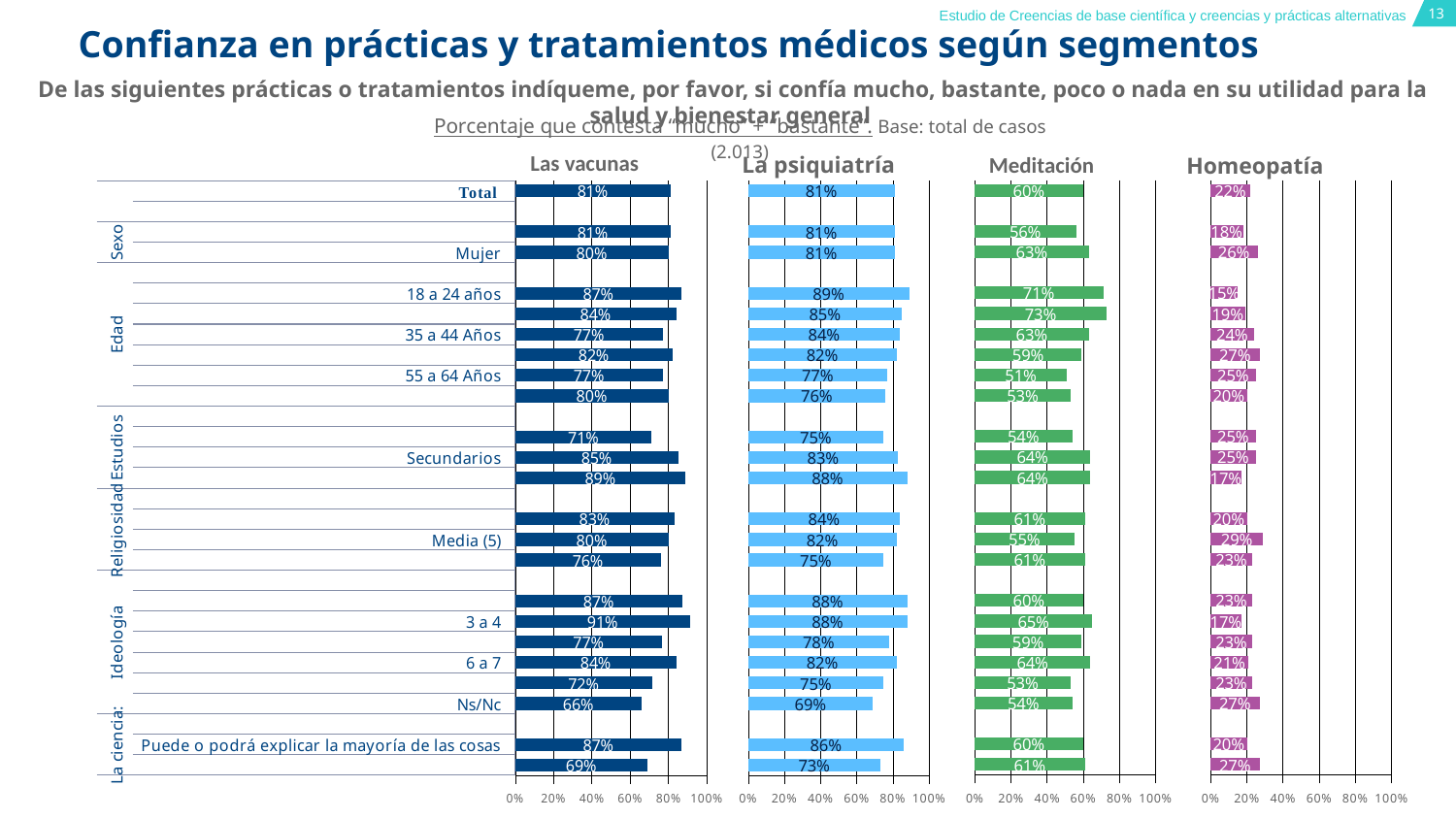
In the Homeopatía chart, what is the value for Mujer? 26% In the Meditación chart, which is larger, the value for Mujer or the value for 55 a 64 Años? Mujer What kind of chart is used for Las vacunas? Bar chart In the Homeopatía chart, which category has the lowest value? 18 a 24 años In the La psiquiatría chart, what is the value for Ns/Nc? 69% How many charts are shown on the slide? 4 In the Homeopatía chart, is the value for Media (5) greater or less than 20%? greater In the Meditación chart, what is the value for 18 a 24 años? 71% In the Las vacunas chart, what is the value for Total? 81% In the Las vacunas chart, which category has the highest value? 3 a 4 In the Las vacunas chart, what is the difference between the values for 3 a 4 and Ns/Nc? 25% In the La psiquiatría chart, what is the difference between the values for 18 a 24 años and 55 a 64 Años? 12%